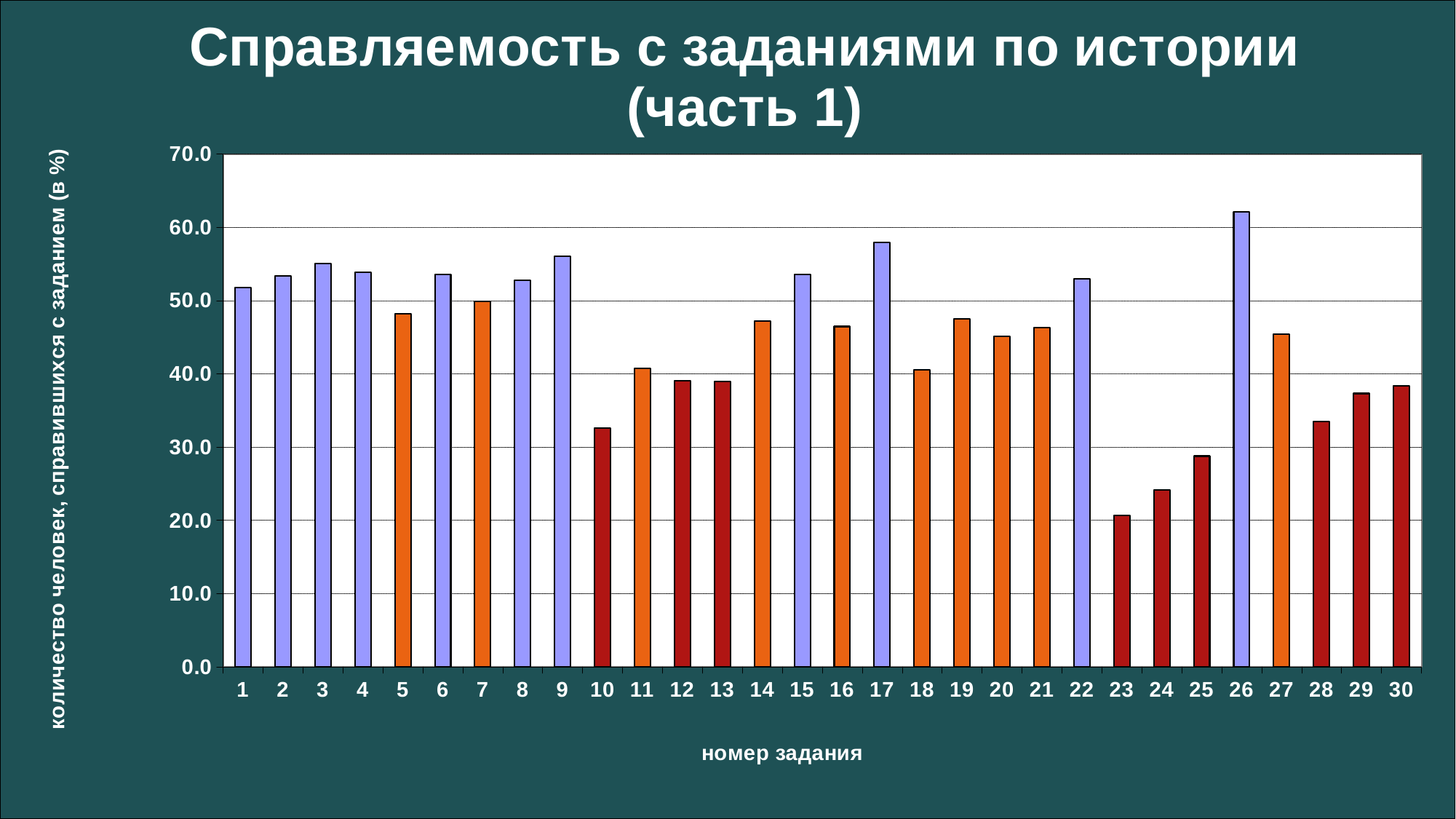
Which task number has the highest value? 26 Is the value for task 10 greater or less than 30.0? greater Is the value for task 24 greater or less than 20.0? greater Which task number has the lowest value? 23 Is the value for task 5 greater or less than 50.0? less What is the label of the x axis? номер задания Which has the larger value, task 3 or task 5? task 3 Which has the larger value, task 23 or task 30? task 30 How many tasks (categories) are plotted on the x axis? 30 What kind of chart is shown on the slide? bar chart